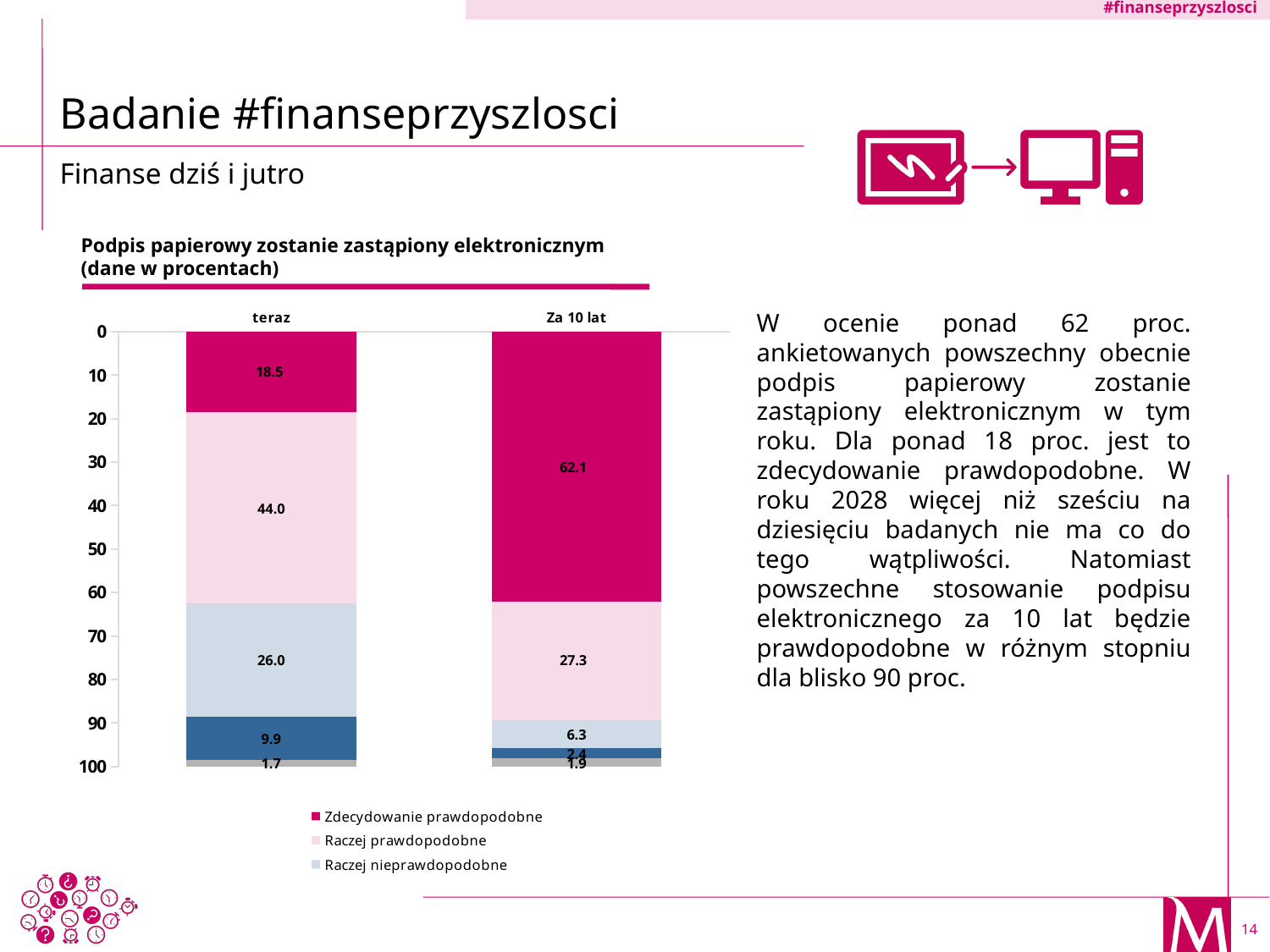
How many series does the chart's legend list? 3 What is the value of "Zdecydowanie prawdopodobne" for "Za 10 lat"? 62.1 How many categories are shown on the x axis of the chart? 2 By how much is "Zdecydowanie prawdopodobne" for "Za 10 lat" larger than for "teraz"? 43.6 What kind of chart is shown on the slide? Stacked bar chart What is the value of "Raczej prawdopodobne" for "Za 10 lat"? 27.3 What is the value of "Raczej prawdopodobne" for "teraz"? 44.0 What is the value of "Zdecydowanie prawdopodobne" for "teraz"? 18.5 What is the value of "Raczej nieprawdopodobne" for "Za 10 lat"? 6.3 Which category has the highest value for "Zdecydowanie prawdopodobne"? Za 10 lat What is the difference between "Raczej nieprawdopodobne" for "teraz" and for "Za 10 lat"? 19.7 Which category has the larger value for "Raczej prawdopodobne", "teraz" or "Za 10 lat"? teraz